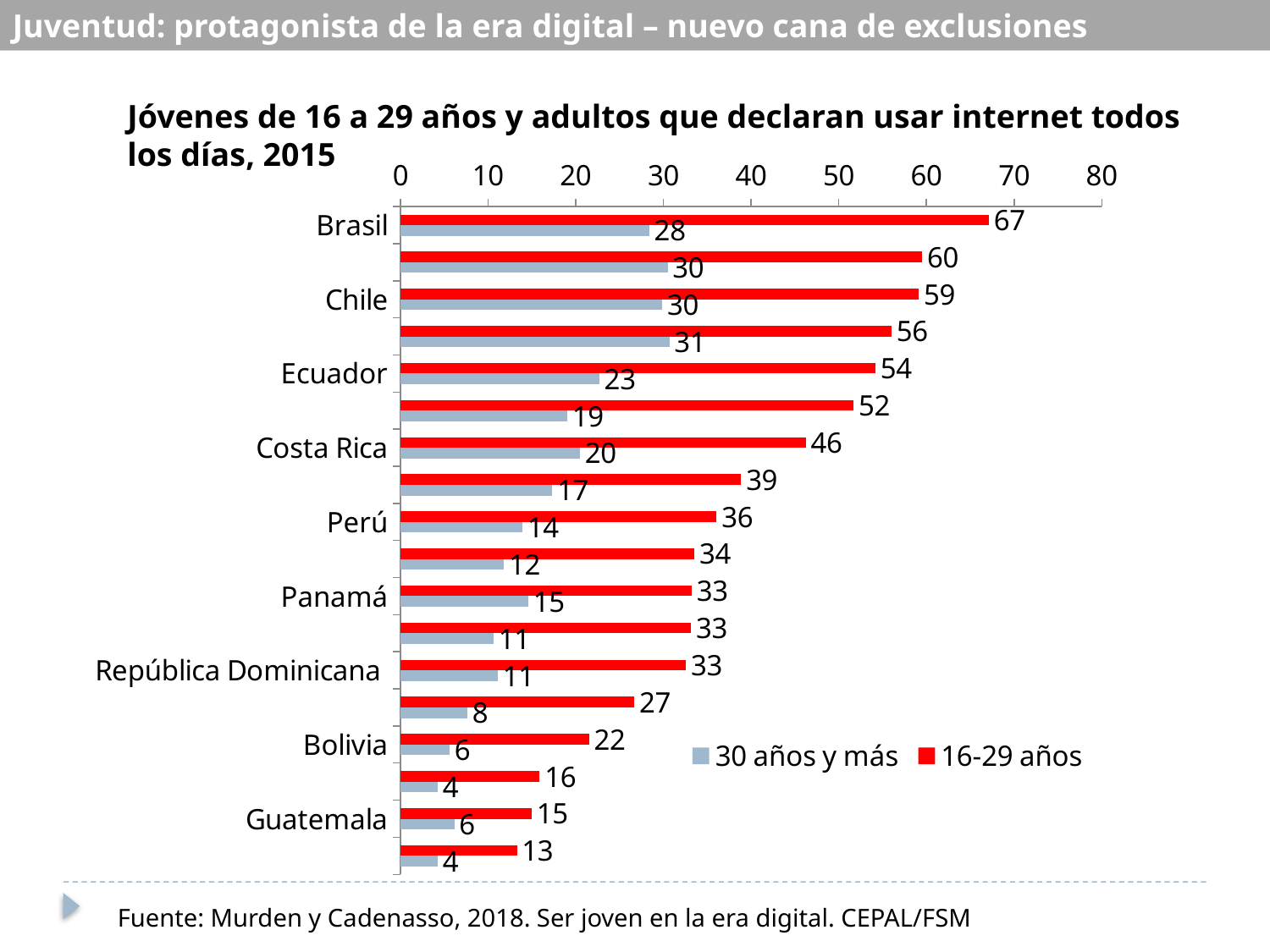
What is the value for the '30 años y más' series for Bolivia? 6 What is the difference between the '16-29 años' and '30 años y más' values for Brasil? 39 What kind of chart is shown on the slide? Bar chart How many series does the legend list? 2 Which country has the highest value for the '16-29 años' series? Brasil What is the value for the '16-29 años' series for Costa Rica? 46 What is the difference between the '16-29 años' and '30 años y más' values for Ecuador? 31 Which has a larger '16-29 años' value, Ecuador or Costa Rica? Ecuador Do the '16-29 años' values rise or fall going from Brasil at the top to Guatemala at the bottom? Fall Is the '16-29 años' value for Perú greater or less than 30? greater What percentage of 16-29 year olds in Brasil declare using the internet every day? 67 What is the value for the '30 años y más' series for Chile? 30